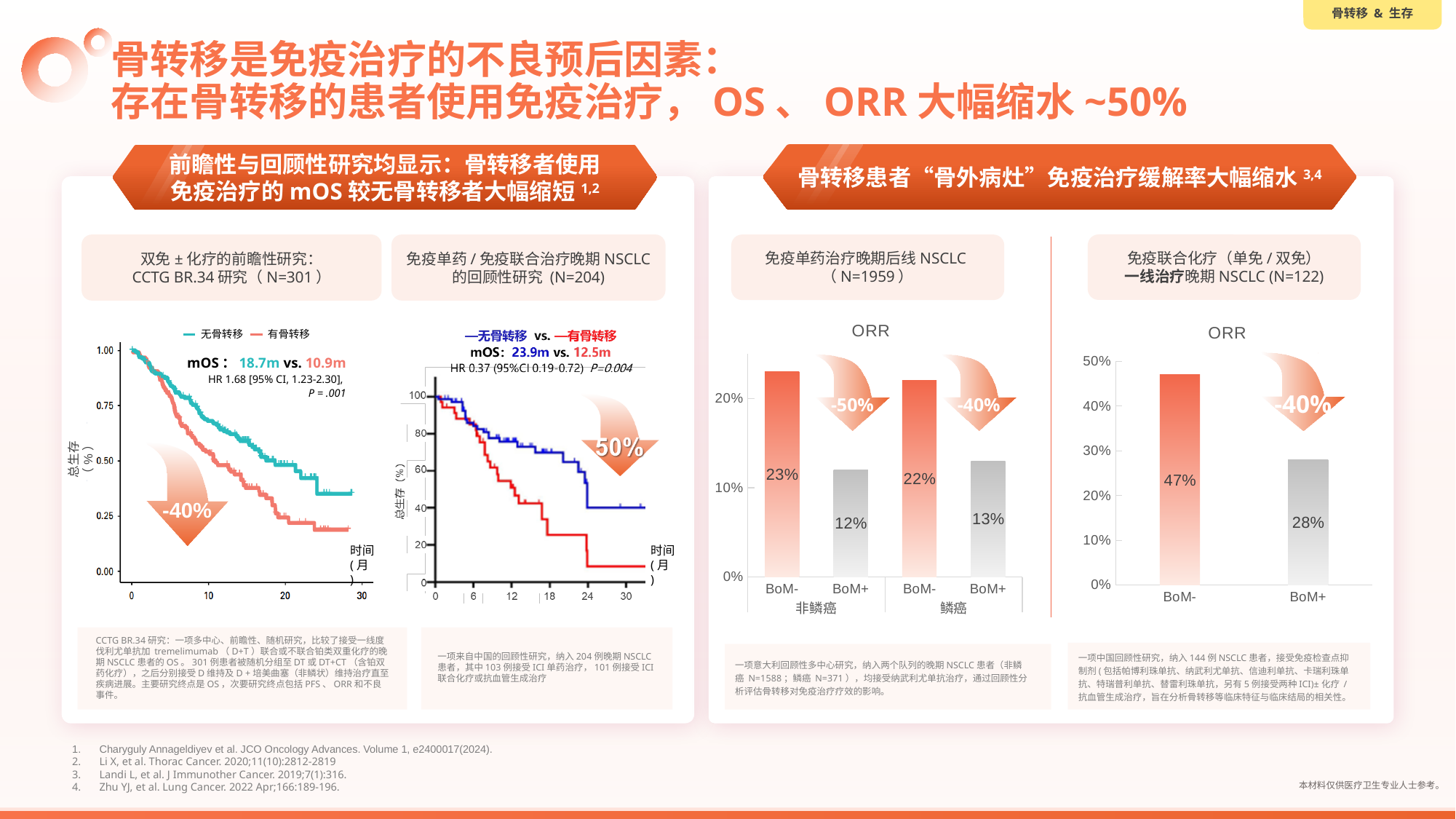
In the ORR bar chart for the N=1959 study (third chart from the left), what is the difference in ORR between BoM- and BoM+ in 鳞癌? 9% In the CCTG BR.34 survival chart (leftmost chart), what is the mOS for patients with bone metastases (有骨转移)? 10.9m In the ORR bar chart for the N=1959 study (third chart from the left), what is the ORR for BoM+ patients with 鳞癌? 13% In the ORR bar chart for the N=1959 study (third chart from the left), what is the ORR for BoM+ patients with 非鳞癌? 12% In the ORR bar chart for the N=1959 study (third chart from the left), which bar is the highest? BoM- 非鳞癌 (23%) In the ORR bar chart for the N=122 study (rightmost chart), what is the ORR for BoM+ patients? 28% In the ORR bar chart for the N=122 study (rightmost chart), what is the ORR for BoM- patients? 47% In the ORR bar chart for the N=122 study (rightmost chart), what is the difference between the BoM- and BoM+ ORR values? 19% In the ORR bar chart for the N=122 study (rightmost chart), is the BoM+ value greater or less than 30%? less In the ORR bar chart for the N=1959 study (third chart from the left), what is the ORR for BoM- patients with 非鳞癌? 23% In the ORR bar chart for the N=1959 study (third chart from the left), how many bars are plotted? 4 What kind of chart is the leftmost chart (CCTG BR.34 study)? Kaplan-Meier survival curve (line chart)